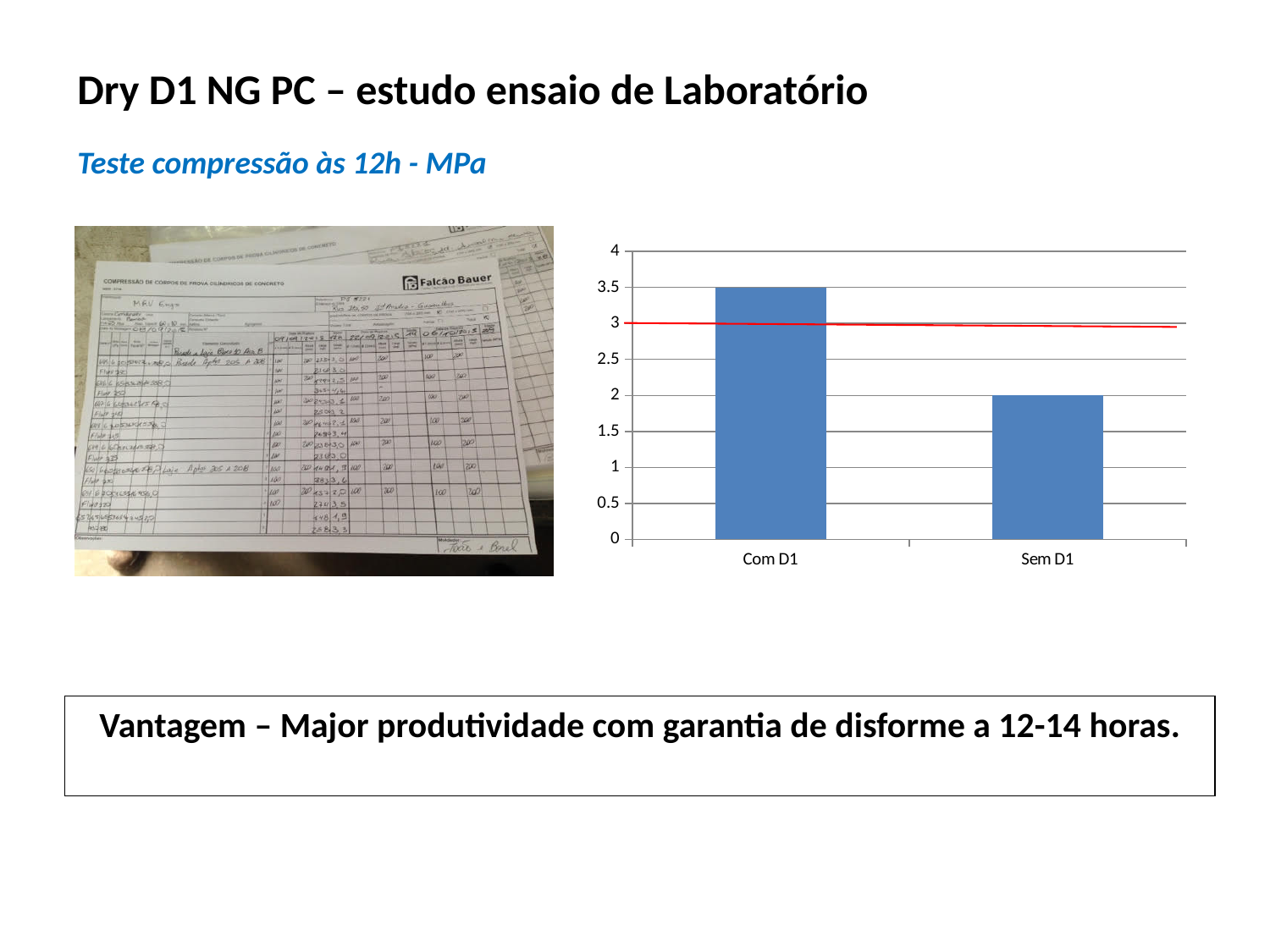
What type of chart is shown on the slide? bar chart At what y-axis value is the red horizontal line drawn across the bar chart? 3 Which category has the lowest value in the bar chart? Sem D1 What is the value for Com D1 in the bar chart? 3.5 How many categories are shown on the x axis of the bar chart? 2 Which category has the highest value in the bar chart? Com D1 What is the difference between the values for Com D1 and Sem D1? 1.5 Is the value for Sem D1 greater or less than 3? less What is the maximum value shown on the y axis of the bar chart? 4 Is the value for Com D1 greater or less than 3? greater Which is larger, the value for Com D1 or the value for Sem D1? Com D1 What is the value for Sem D1 in the bar chart? 2